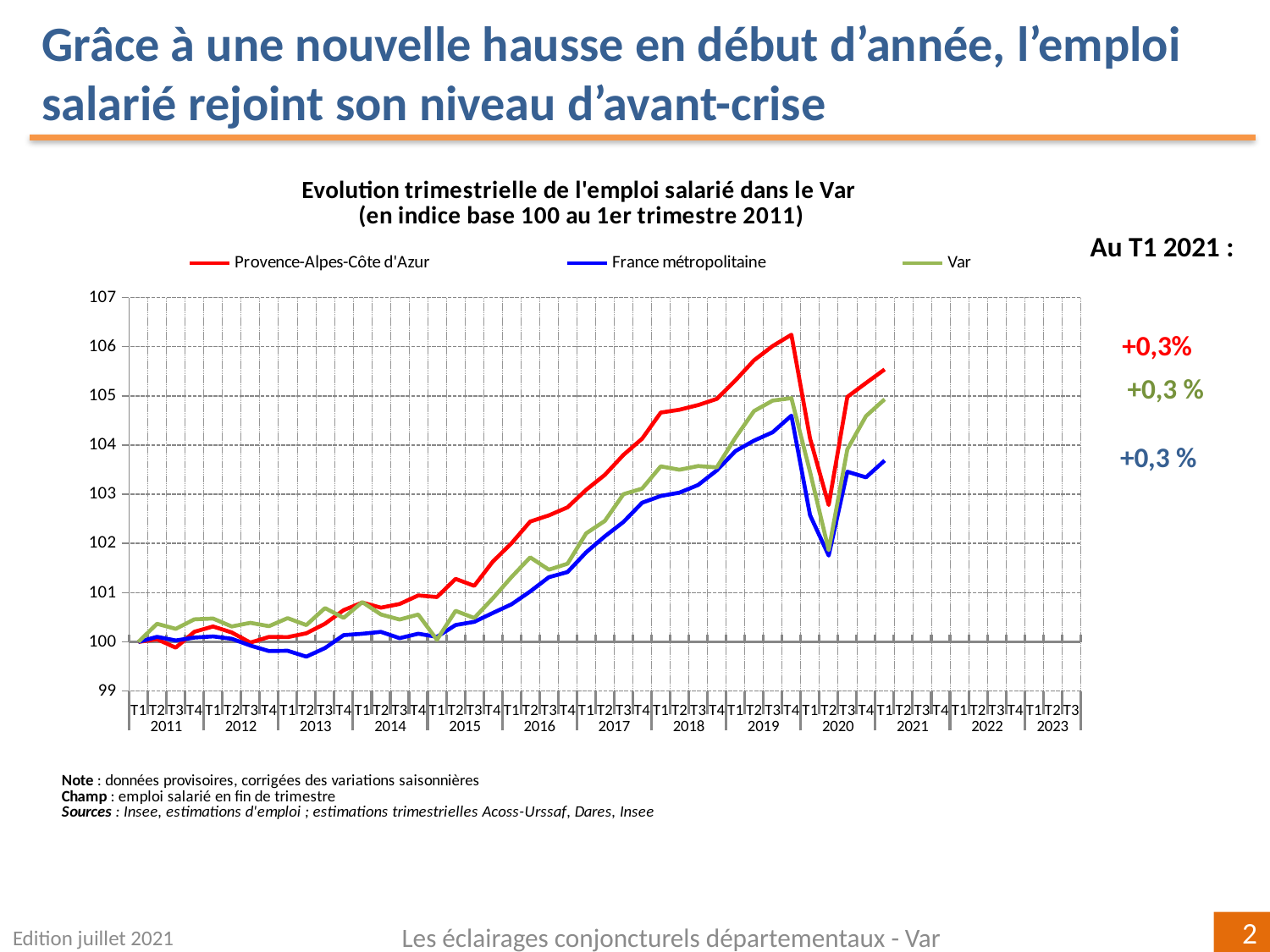
Does the Provence-Alpes-Côte d'Azur series generally rise or fall between T1 2011 and T4 2019? rise Is the value for France métropolitaine at T2 2020 greater or less than 103? less What type of chart is shown on the slide? line chart Which series has the highest value at T1 2021? Provence-Alpes-Côte d'Azur Is the value for Provence-Alpes-Côte d'Azur at T4 2019 greater or less than 105? greater What is the index value of all three series at T1 2011? 100 Which series has the lowest value at T1 2021? France métropolitaine What is the title of the chart? Evolution trimestrielle de l'emploi salarié dans le Var (en indice base 100 au 1er trimestre 2011) How many series does the legend list? 3 Is the value for Var at T1 2021 greater or less than 104? greater At T1 2021, which is larger: the value for Var or the value for France métropolitaine? Var According to the annotation on the right, what was the change for Var at T1 2021? +0,3 %